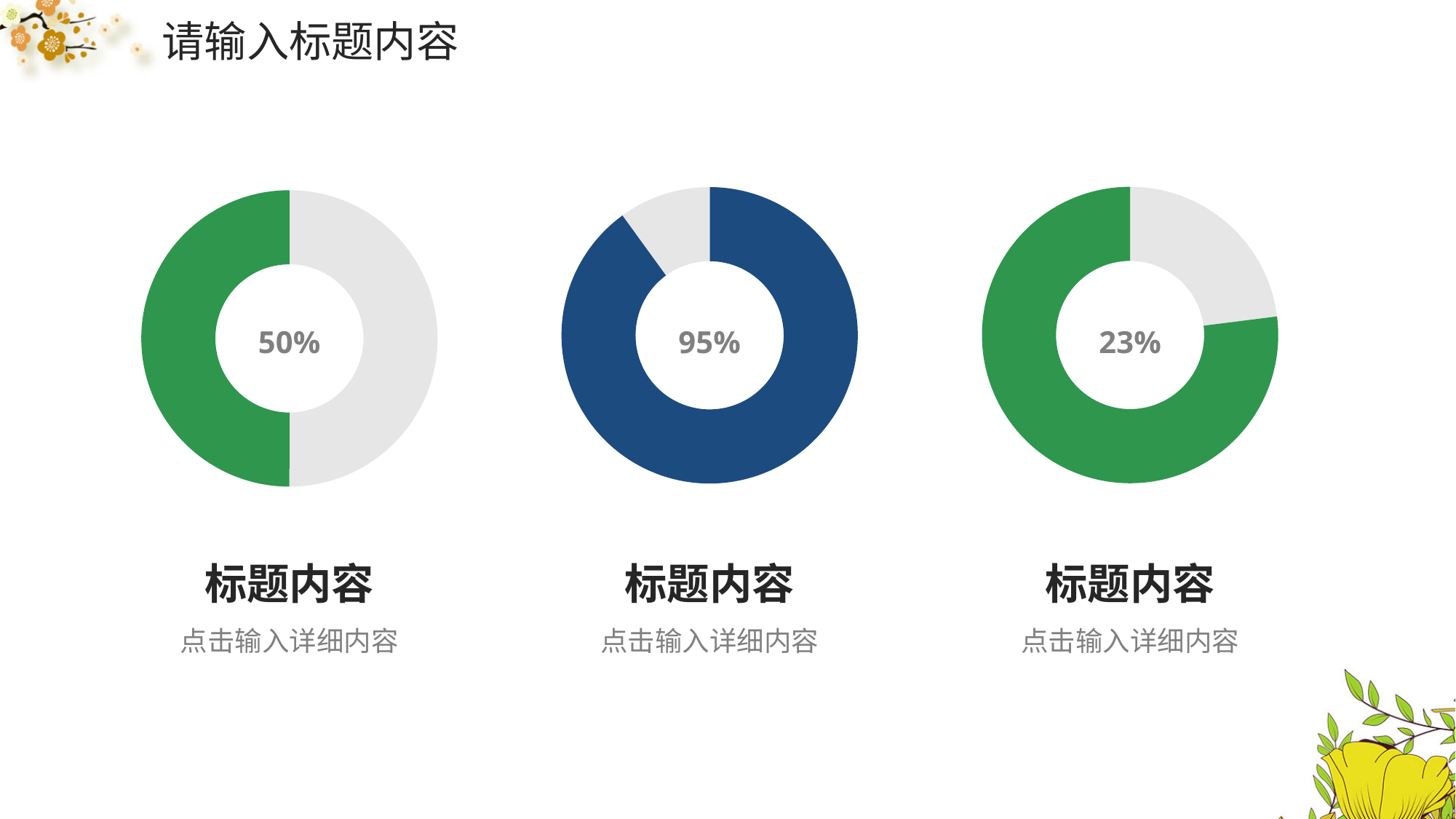
What is the difference between the percentage in the left chart and the percentage in the right chart? 27% What is the difference between the percentage in the middle chart and the percentage in the left chart? 45% How many donut charts are on the slide? 3 Which of the three donut charts shows the lowest percentage? the right chart What percentage is shown in the centre of the left donut chart? 50% What colour is the filled portion of the middle donut chart? blue What kind of chart is used on this slide? donut chart What is the difference between the percentage in the middle chart and the percentage in the right chart? 72% What percentage is shown in the centre of the middle donut chart? 95% Which of the three donut charts shows the highest percentage? the middle chart Which shows a larger percentage, the left chart or the right chart? the left chart What percentage is shown in the centre of the right donut chart? 23%